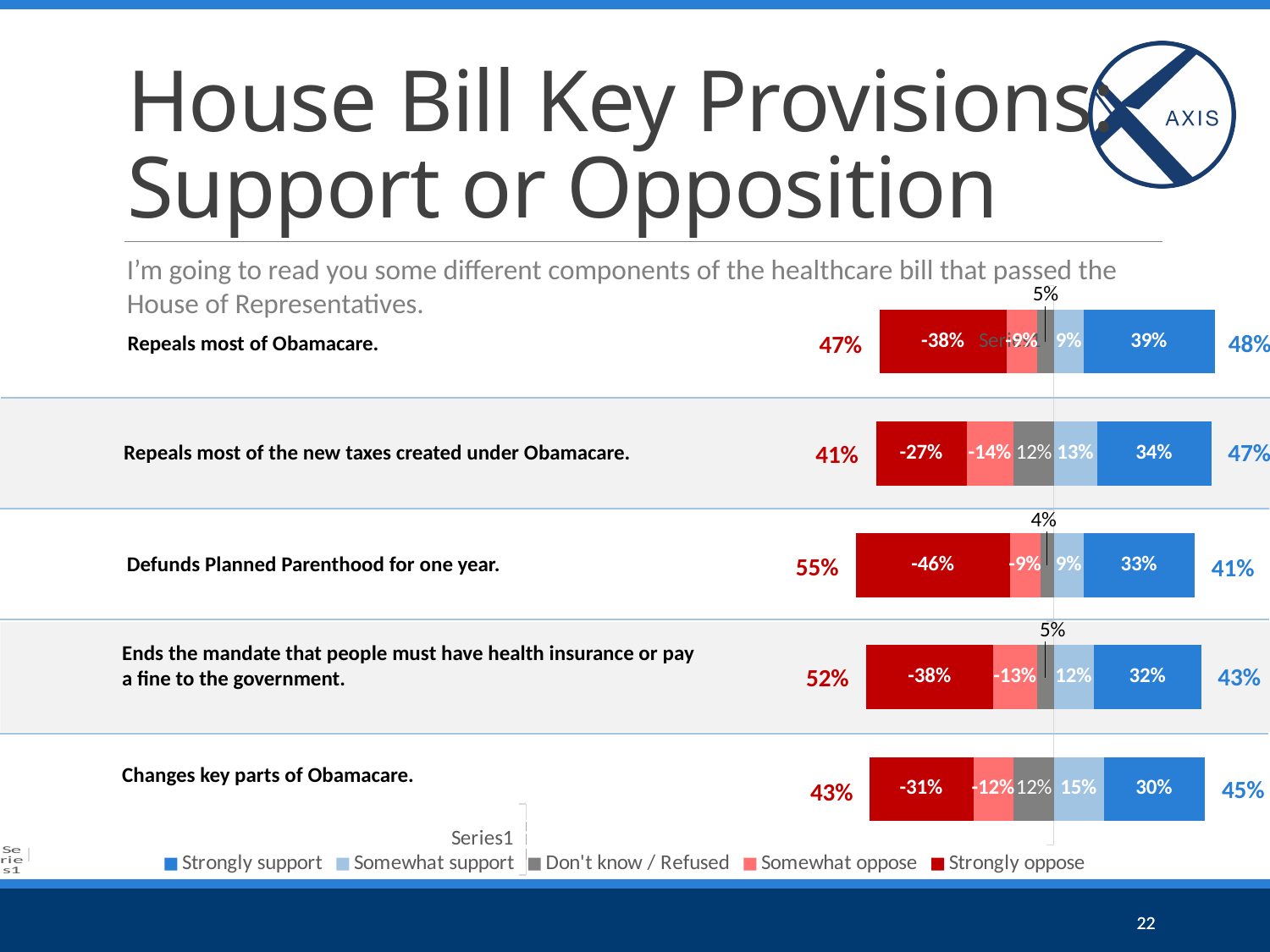
What is the Strongly support value for "Defunds Planned Parenthood for one year"? 33% What is the difference between the Strongly support values for "Repeals most of Obamacare" and "Changes key parts of Obamacare"? 9% Which provision has the lowest Strongly support value? Changes key parts of Obamacare. Which is larger: the Somewhat oppose value for "Repeals most of the new taxes created under Obamacare" or for "Changes key parts of Obamacare"? Repeals most of the new taxes created under Obamacare. Which legend entry is shown in dark red? Strongly oppose What kind of chart is shown on the slide? bar chart What is the Somewhat support value for "Changes key parts of Obamacare"? 15% Which provision has the highest Strongly support value? Repeals most of Obamacare. How many provisions (categories) are plotted in the chart? 5 How many series does the legend list? 5 What is the Don't know / Refused value for "Ends the mandate that people must have health insurance or pay a fine to the government"? 5% What is the Strongly oppose value for "Repeals most of the new taxes created under Obamacare"? -27%